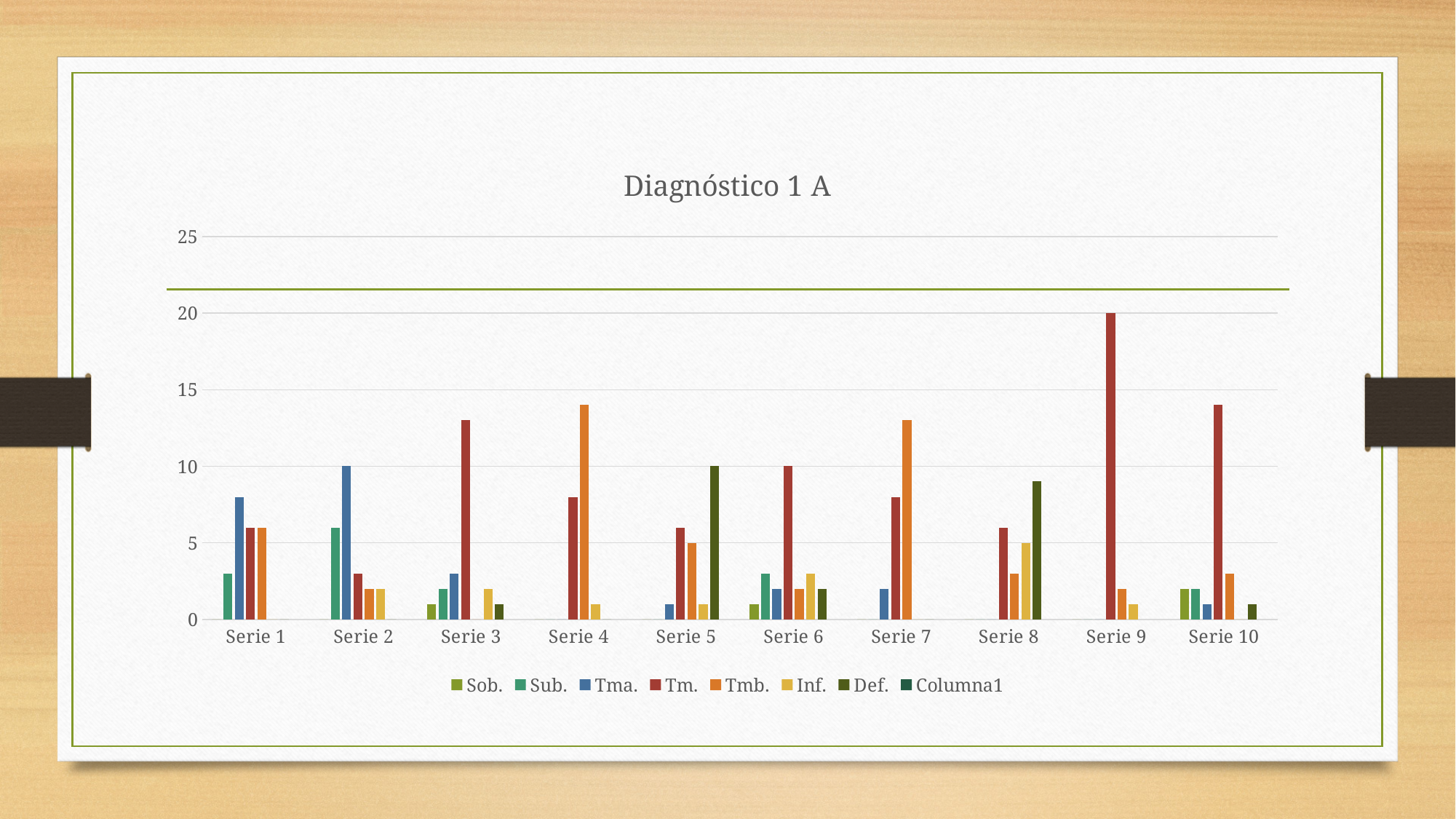
What is the value of Def. for Serie 5? 10 What is the title of the chart? Diagnóstico 1 A Is the value of Tmb. for Serie 7 greater or less than 10? greater Which category contains the tallest bar in the chart? Serie 9 How many categories are shown on the x axis of the chart? 10 Which is larger, the Tm. value for Serie 9 or the Tm. value for Serie 3? Serie 9 Is the value of Tm. for Serie 3 greater or less than 10? greater What is the value of Tma. for Serie 2? 10 How many series does the legend list? 8 Is the value of Tma. for Serie 1 greater or less than 5? greater What type of chart is shown on the slide? bar chart What is the value of Tm. for Serie 9? 20